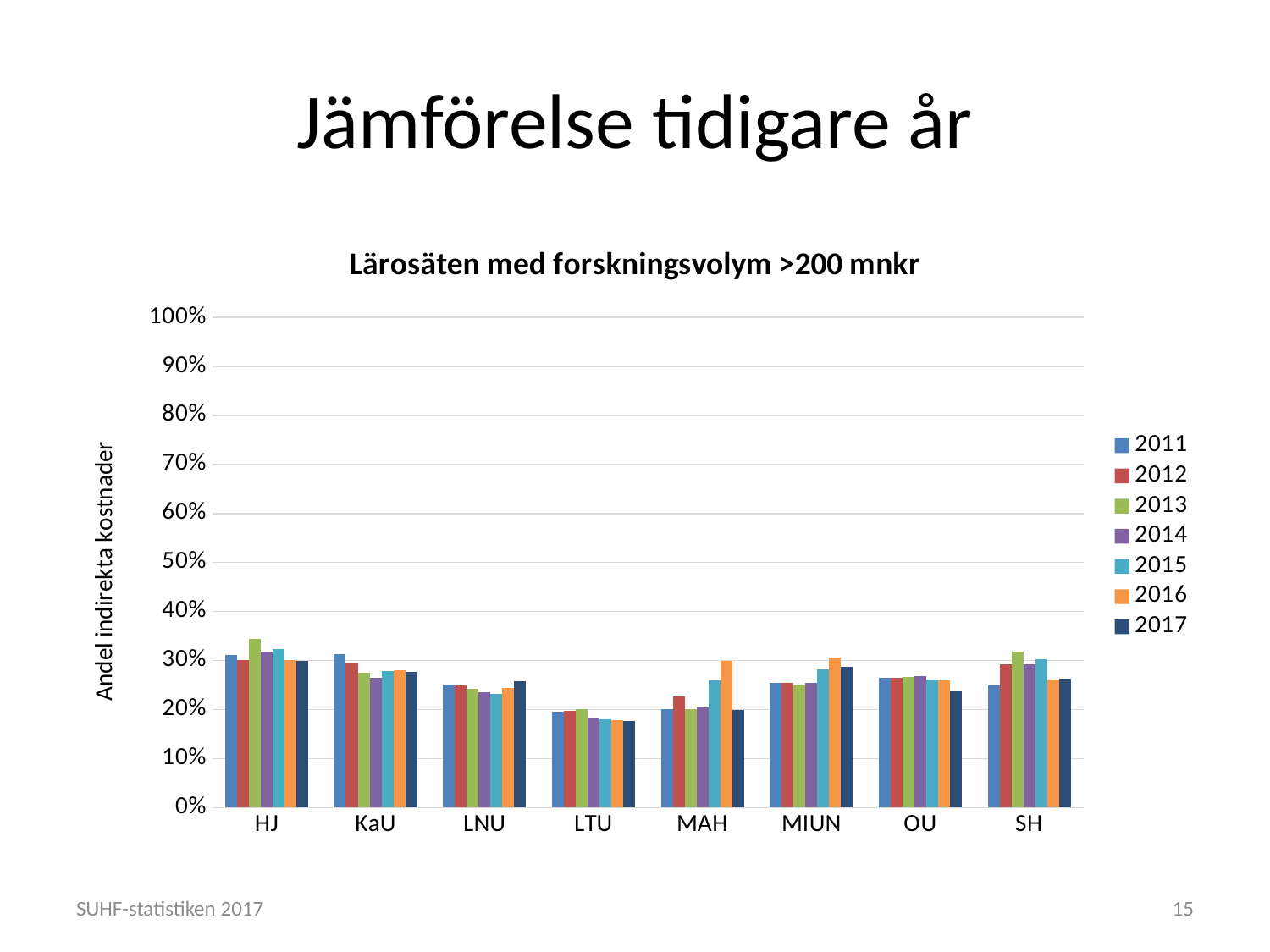
For 2011, which is larger: the value for HJ or the value for LTU? HJ What is the label on the vertical axis? Andel indirekta kostnader For MAH, which is larger: the value for 2016 or the value for 2017? 2016 How many institutions (categories) are shown on the x axis? 8 Is the value for HJ in 2013 greater or less than 30%? greater Is the value for OU in 2017 greater or less than 30%? less Is the value for MAH in 2012 greater or less than 20%? greater Which institution has the lowest value for 2017? LTU What kind of chart is shown on the slide? bar chart How many series does the legend list? 7 What is the title of the chart? Lärosäten med forskningsvolym >200 mnkr